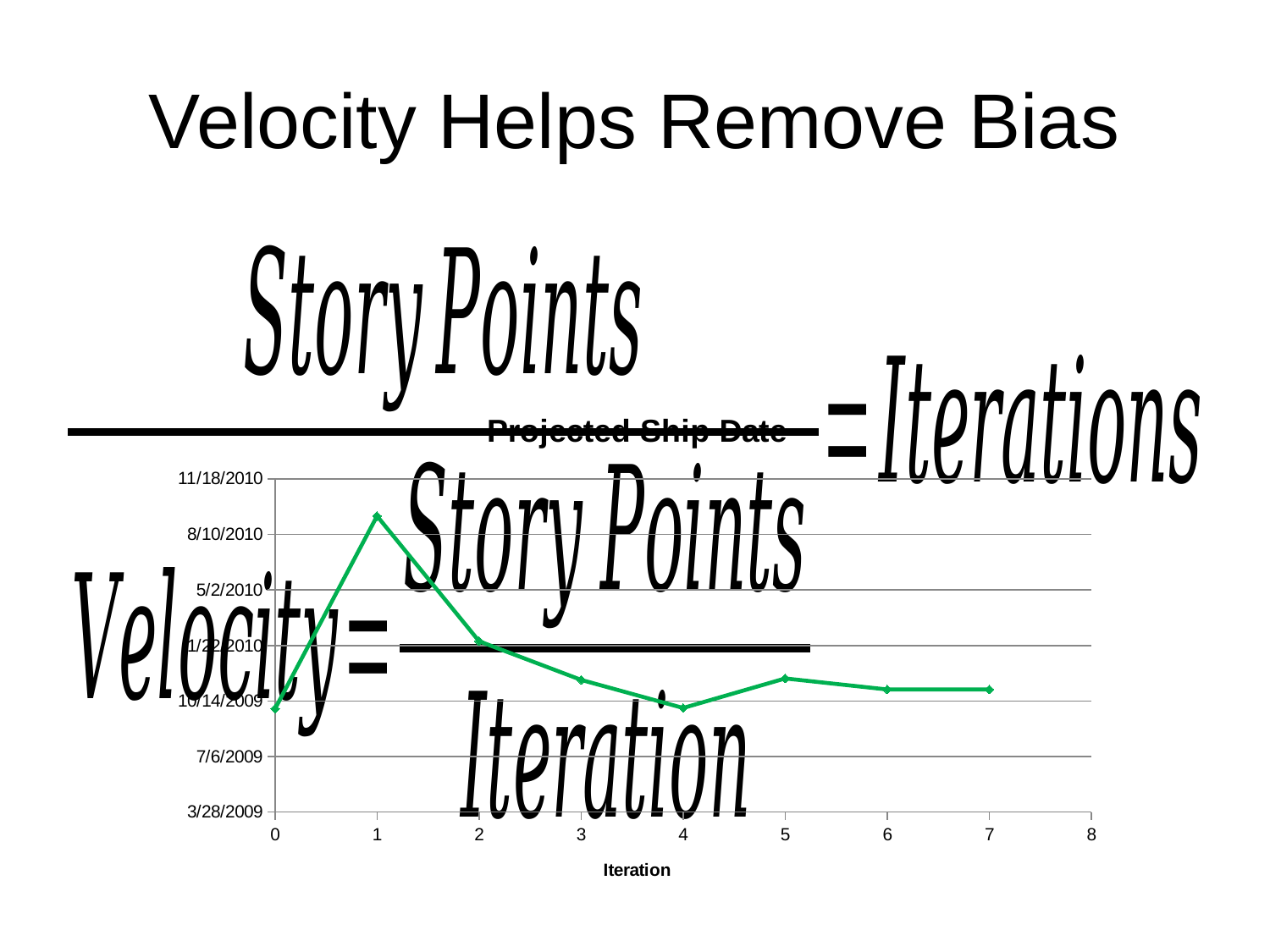
Does the projected ship date rise or fall from iteration 0 to iteration 1? rise Does the projected ship date rise or fall from iteration 1 to iteration 4? fall Is the projected ship date at iteration 1 later or earlier than 8/10/2010? later How many data points are plotted on the line? 8 Is the projected ship date at iteration 3 later or earlier than 1/22/2010? earlier Is the projected ship date at iteration 0 later or earlier than 1/22/2010? earlier Which has the later projected ship date, iteration 1 or iteration 2? iteration 1 At which iteration is the projected ship date the latest (highest point)? 1 Which has the later projected ship date, iteration 2 or iteration 4? iteration 2 What is the title of the chart? Projected Ship Date What kind of chart is shown on the slide? line chart What is the label of the x axis of the chart? Iteration